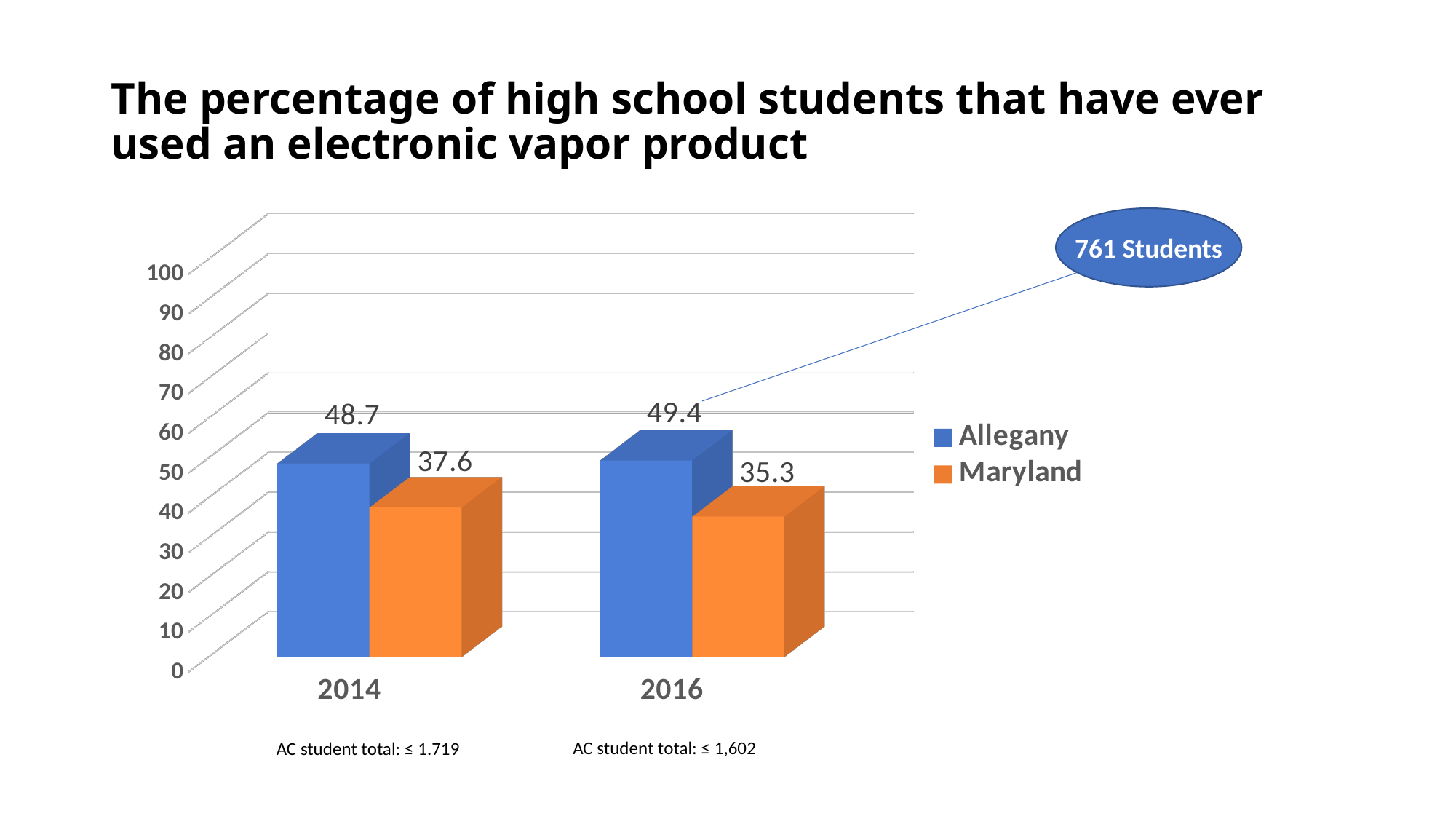
What is the value for Allegany in 2014? 48.7 How many series does the legend list? 2 What kind of chart is shown? Bar chart Which series has the lowest value in 2014? Maryland Which series has the highest value in 2016? Allegany Which is larger: Maryland in 2014 or Maryland in 2016? Maryland in 2014 Does the Maryland value rise or fall from 2014 to 2016? Fall What is the difference between the Allegany and Maryland values in 2016? 14.1 What is the value for Maryland in 2016? 35.3 How many categories are shown on the x axis? 2 What is the value for Maryland in 2014? 37.6 What is the value for Allegany in 2016? 49.4